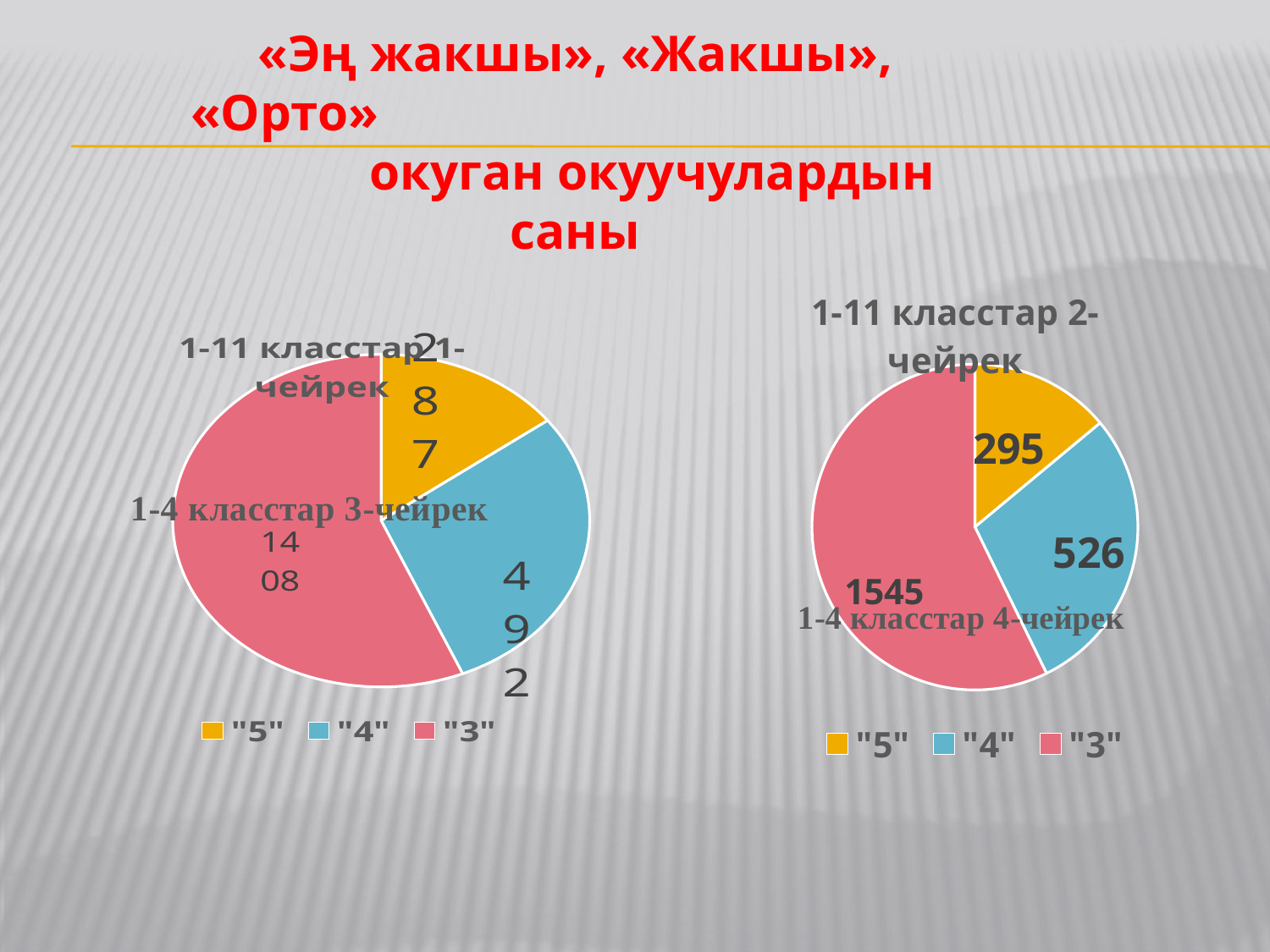
In the chart titled "1-11 класстар 2-чейрек", which category has the smallest slice? "5" In the chart titled "1-11 класстар 2-чейрек", what is the value for "4"? 526 In the left pie chart (1-11 класстар 1-чейрек), which category has the largest slice? "3" In the chart titled "1-11 класстар 2-чейрек", what is the difference between the values for "4" and "5"? 231 In the chart titled "1-11 класстар 2-чейрек", what is the value for "3"? 1545 In the chart titled "1-11 класстар 2-чейрек", which is larger, the value for "4" or the value for "5"? "4" How many slices does the chart titled "1-11 класстар 2-чейрек" have? 3 What kind of chart is the chart titled "1-11 класстар 2-чейрек"? pie chart How many entries does the legend of the left pie chart (1-11 класстар 1-чейрек) list? 3 In the chart titled "1-11 класстар 2-чейрек", what is the difference between the values for "3" and "4"? 1019 In the chart titled "1-11 класстар 2-чейрек", which category has the largest slice? "3" In the chart titled "1-11 класстар 2-чейрек", what is the value for "5"? 295